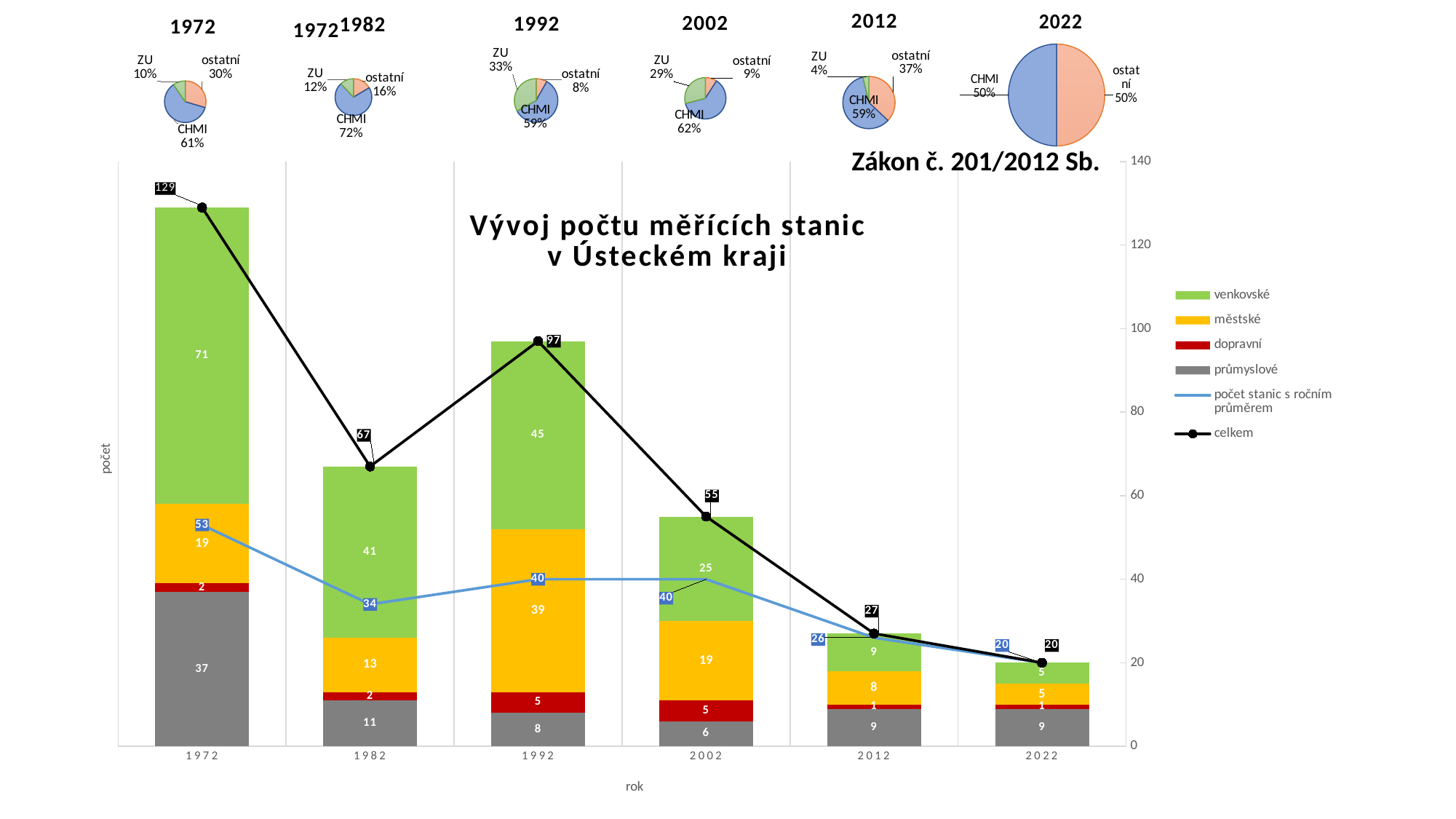
What kind of chart is the main chart 'Vývoj počtu měřících stanic v Ústeckém kraji'? Stacked bar chart with line series In the main chart 'Vývoj počtu měřících stanic v Ústeckém kraji', what is the value of the 'celkem' series for 1972? 129 In the main chart 'Vývoj počtu měřících stanic v Ústeckém kraji', what is the difference between the 'celkem' values for 1972 and 1982? 62 In the main chart 'Vývoj počtu měřících stanic v Ústeckém kraji', which year has the lowest 'celkem' value? 2022 In the main chart 'Vývoj počtu měřících stanic v Ústeckém kraji', what is the value of 'počet stanic s ročním průměrem' for 1982? 34 In the pie chart for 1982, what share does CHMI have? 72% In the main chart 'Vývoj počtu měřících stanic v Ústeckém kraji', what is the 'venkovské' value for 1992? 45 In the main chart 'Vývoj počtu měřících stanic v Ústeckém kraji', how many years are shown on the x axis? 6 In the main chart 'Vývoj počtu měřících stanic v Ústeckém kraji', is the 'městské' value larger for 1992 or for 2002? 1992 In the main chart 'Vývoj počtu měřících stanic v Ústeckém kraji', how many series does the legend list? 6 In the main chart 'Vývoj počtu měřících stanic v Ústeckém kraji', what is the 'průmyslové' value for 1972? 37 In the pie chart for 2012, what share does 'ostatní' have? 37%